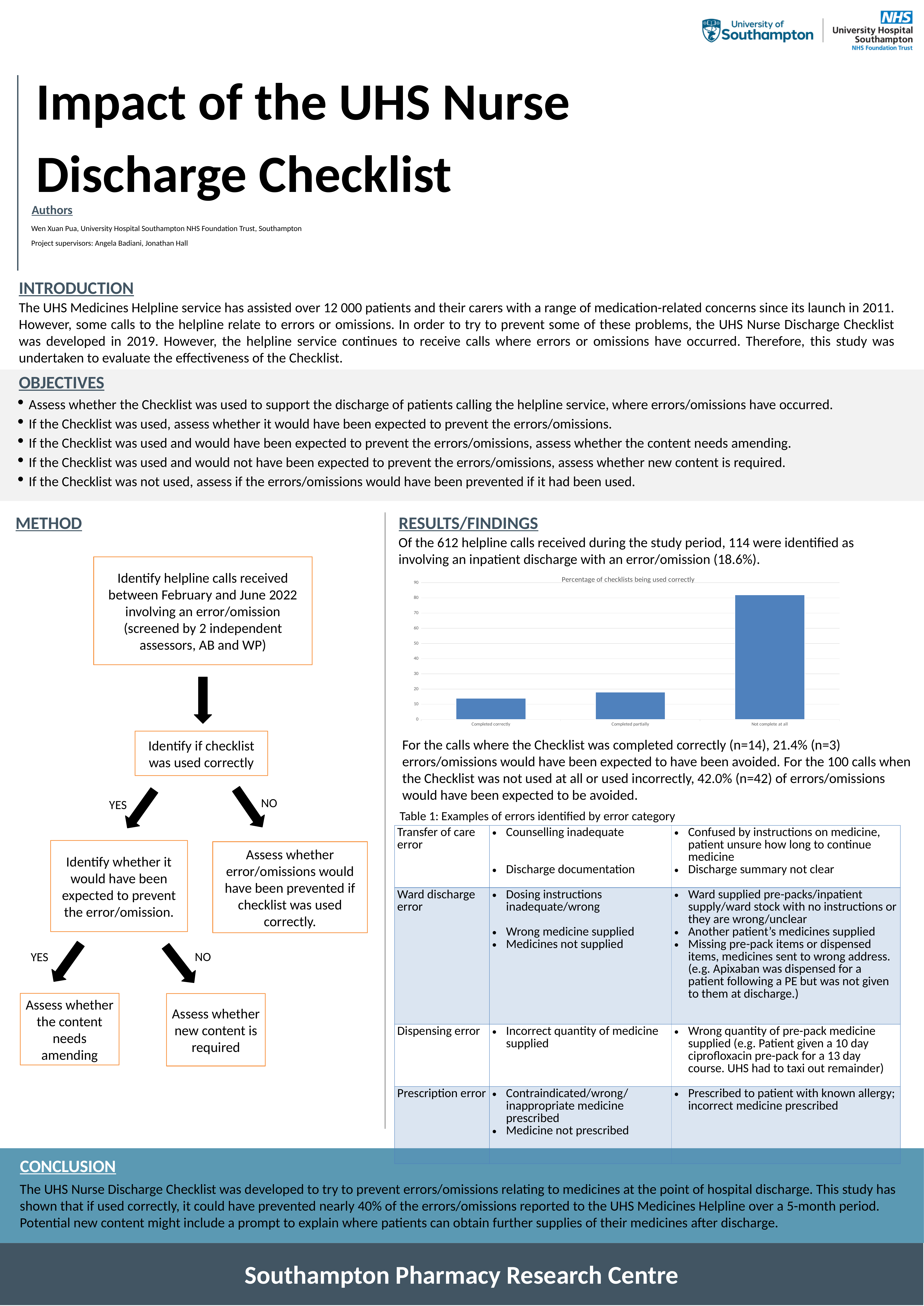
Which category has the lowest bar in the chart? Completed correctly Which is larger in the chart, the value for Completed partially or the value for Completed correctly? Completed partially Do the bar values rise or fall from left to right along the x axis? rise Is the value for Not complete at all greater or less than 70? greater Which category has the highest bar in the chart? Not complete at all Is the value for Completed correctly greater or less than 20? less What is the highest value shown on the chart's y axis? 90 Is the value for Completed partially greater or less than 10? greater What is the title of the chart? Percentage of checklists being used correctly How many categories are shown on the chart's x axis? 3 What kind of chart is shown under Results/Findings? bar chart